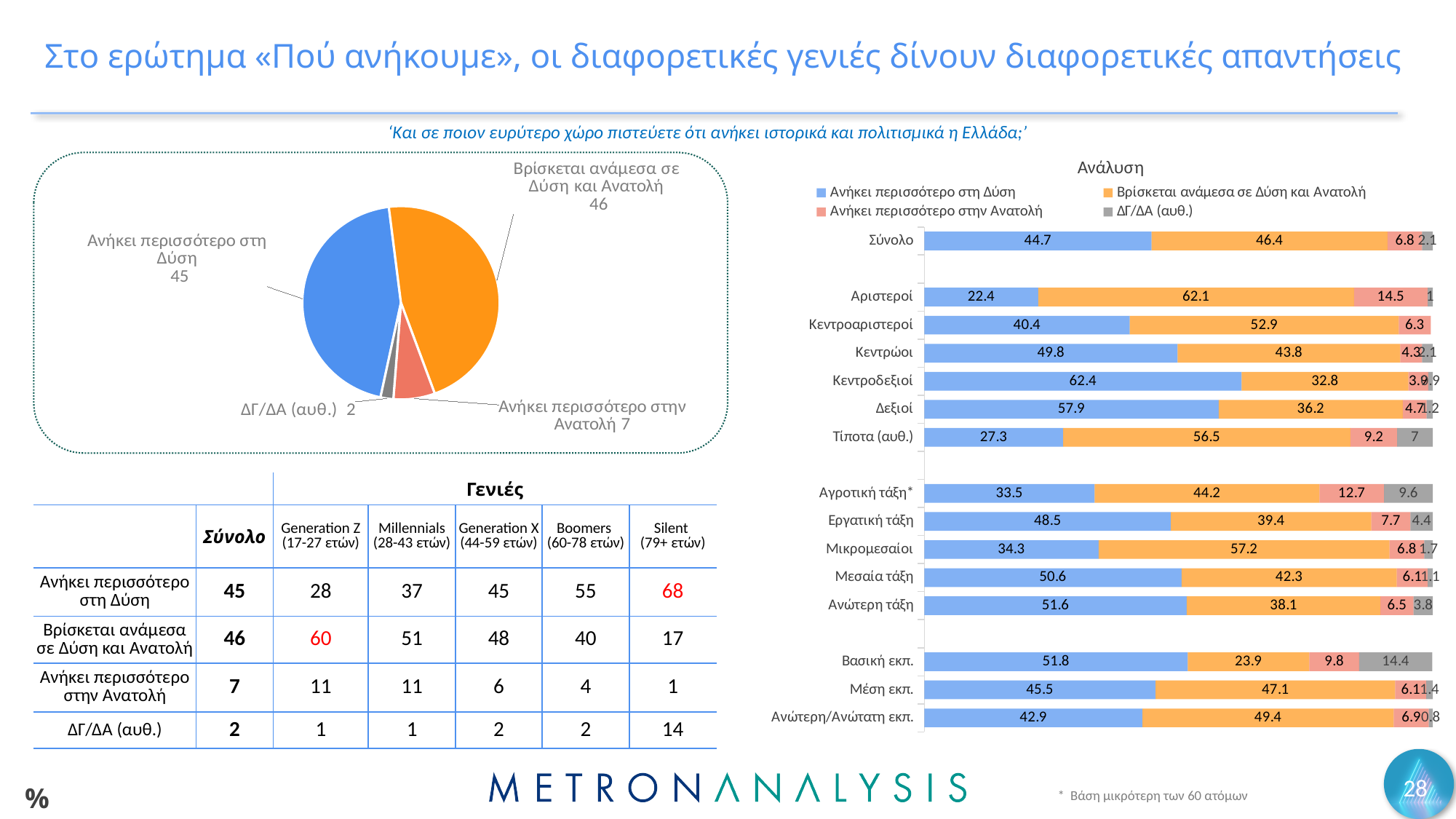
In the 'Ανάλυση' chart on the right, what kind of chart is it? Stacked bar chart In the 'Ανάλυση' chart on the right, which is larger: 'Ανήκει περισσότερο στην Ανατολή' for 'Αγροτική τάξη*' or for 'Εργατική τάξη'? Αγροτική τάξη* In the pie chart on the left, how many slices are there? 4 In the pie chart on the left, which slice is the smallest? ΔΓ/ΔΑ (αυθ.) In the 'Ανάλυση' chart on the right, which category has the highest value for 'Ανήκει περισσότερο στη Δύση'? Κεντροδεξιοί In the pie chart on the left, what value is shown for 'Βρίσκεται ανάμεσα σε Δύση και Ανατολή'? 46 In the 'Ανάλυση' chart on the right, how many series does the legend list? 4 In the 'Ανάλυση' chart on the right, what is the difference between 'Ανήκει περισσότερο στη Δύση' for 'Δεξιοί' and for 'Τίποτα (αυθ.)'? 30.6 In the 'Ανάλυση' chart on the right, what is the value of 'Βρίσκεται ανάμεσα σε Δύση και Ανατολή' for 'Αριστεροί'? 62.1 In the 'Ανάλυση' chart on the right, which category has the lowest value for 'Ανήκει περισσότερο στη Δύση'? Αριστεροί In the pie chart on the left, what is the difference between 'Ανήκει περισσότερο στη Δύση' and 'Ανήκει περισσότερο στην Ανατολή'? 38 In the 'Ανάλυση' chart on the right, what is the value of 'Ανήκει περισσότερο στη Δύση' for 'Κεντροδεξιοί'? 62.4